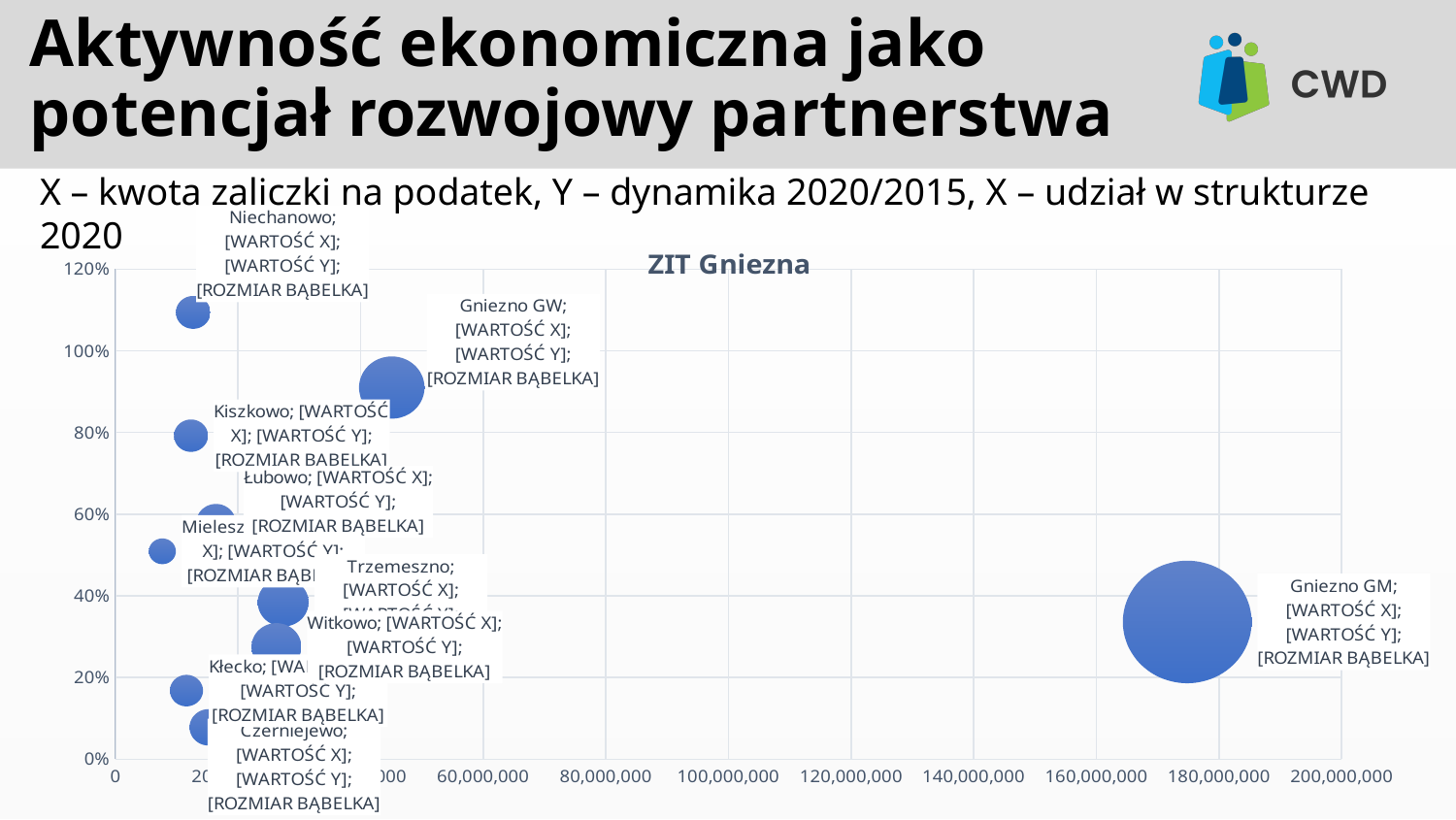
Is the Y value for Gniezno GW greater or less than 80%? greater What kind of chart is shown on the slide? bubble chart Which bubble has the lowest value on the Y axis? Czerniejewo Which bubble has the highest value on the Y axis? Niechanowo How many labelled bubbles are plotted on the chart? 10 Is the X value for Gniezno GM greater or less than 160,000,000? greater Is the Y value for Czerniejewo greater or less than 20%? less Which bubble is the largest in size? Gniezno GM Which bubble is furthest to the right on the X axis? Gniezno GM What is the title of the chart? ZIT Gniezna Which has the higher Y value, Kiszkowo or Kłecko? Kiszkowo